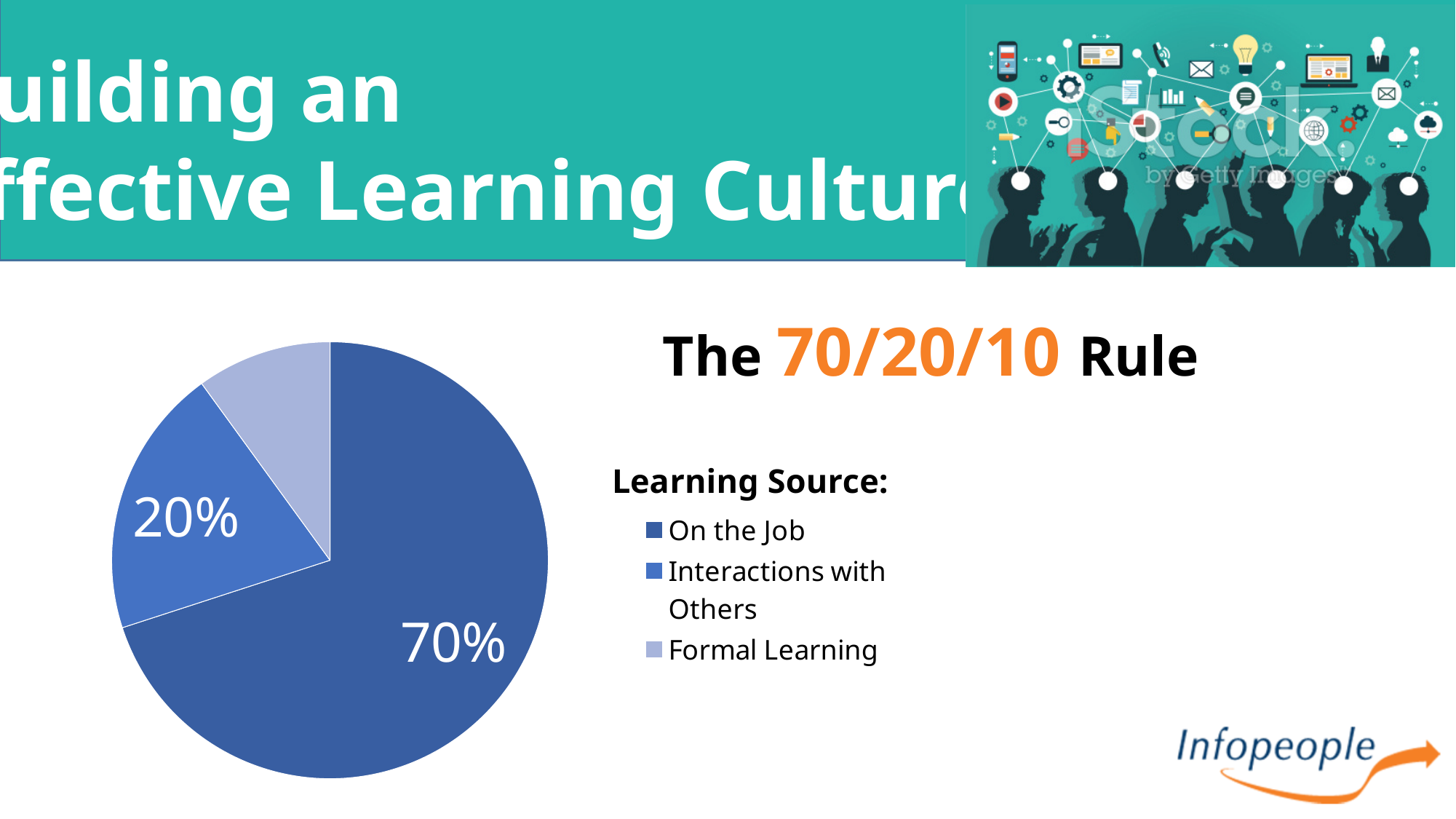
How many slices does the pie chart have? 3 How many entries does the legend list? 3 Which learning source has the smallest slice of the pie chart? Formal Learning Which learning source has the largest slice of the pie chart? On the Job What is the difference in percentage points between the On the Job slice and the Interactions with Others slice? 50% What percentage of the pie chart is labelled for On the Job? 70% Which slice is larger, On the Job or Interactions with Others? On the Job What colour is the On the Job slice in the pie chart? dark blue What percentage of the pie chart is labelled for Interactions with Others? 20% What is the heading shown above the legend entries? Learning Source: Which slice is larger, Interactions with Others or Formal Learning? Interactions with Others What kind of chart is shown on the slide? pie chart